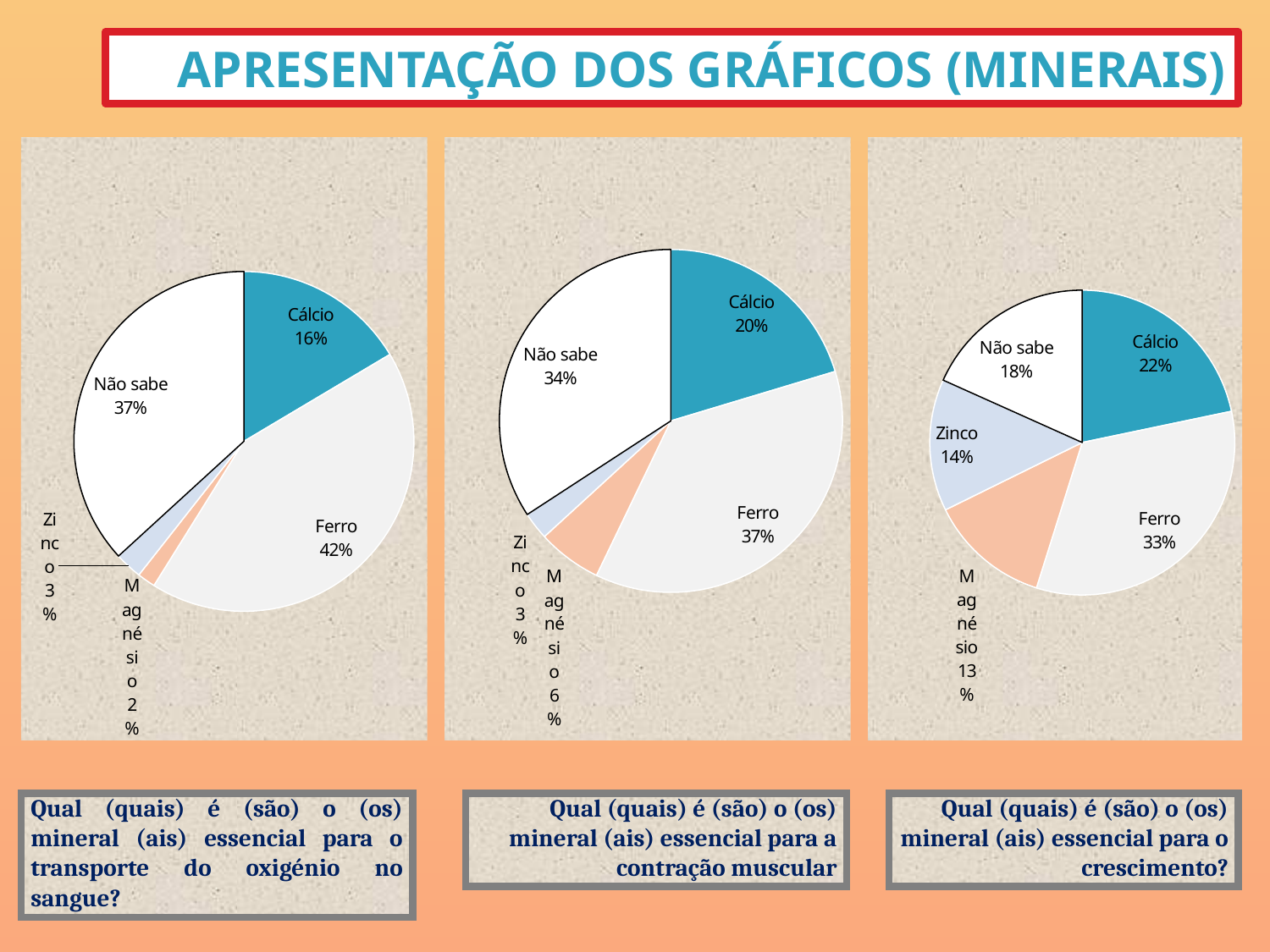
In the left pie chart, what percentage is shown for Ferro? 42% In the middle pie chart, what is the difference between the Ferro share and the Cálcio share? 17% In the middle pie chart, what percentage is shown for Não sabe? 34% How many categories does the right pie chart show? 5 In the left pie chart, which category has the largest share? Ferro In the right pie chart, which category has the smallest share? Magnésio In the middle pie chart, which is larger, Magnésio or Zinco? Magnésio In the right pie chart, what is the difference between the Ferro share and the Não sabe share? 15% In the left pie chart, which category has the smallest share? Magnésio In the left pie chart, what colour is the Cálcio slice? Teal blue What type of chart is the middle chart? Pie chart In the right pie chart, what percentage is shown for Zinco? 14%